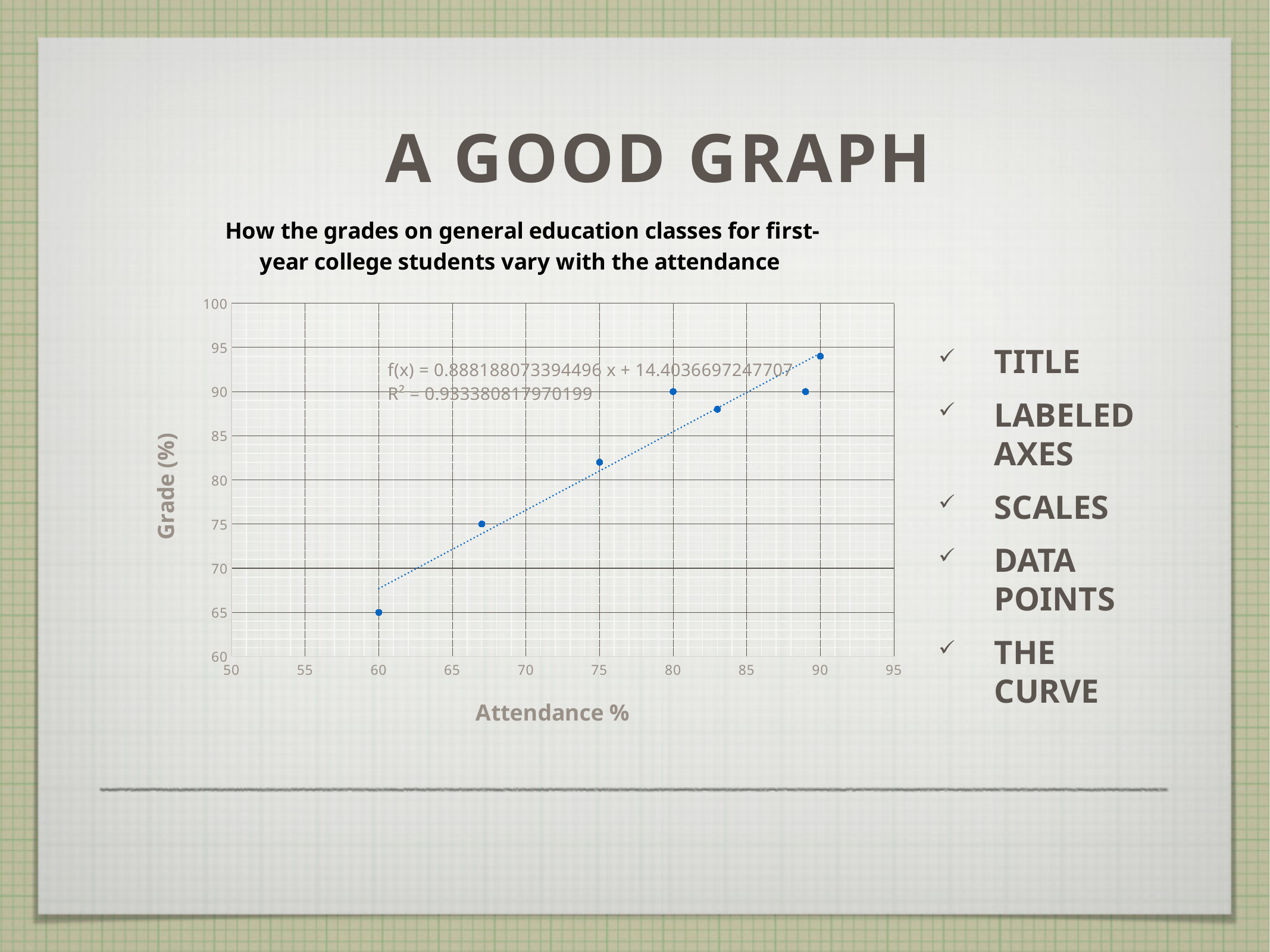
What is the grade (%) for the data point at 80% attendance? 90 Which attendance value has the highest grade on the chart? 90 What kind of chart is shown on the slide? Scatter chart What is the label of the x axis? Attendance % Is the grade for the data point at 75% attendance greater or less than 80? greater What is the grade (%) for the data point at 60% attendance? 65 Which data point has a higher grade: the one at 60% attendance or the one at 80% attendance? 80% attendance Do grades rise or fall as attendance increases along the x axis? rise What R² value is printed on the chart for the trendline? 0.933380817970199 Is the grade for the data point at 67% attendance greater or less than 80? less How many data points are plotted on the chart? 7 Which attendance value has the lowest grade on the chart? 60